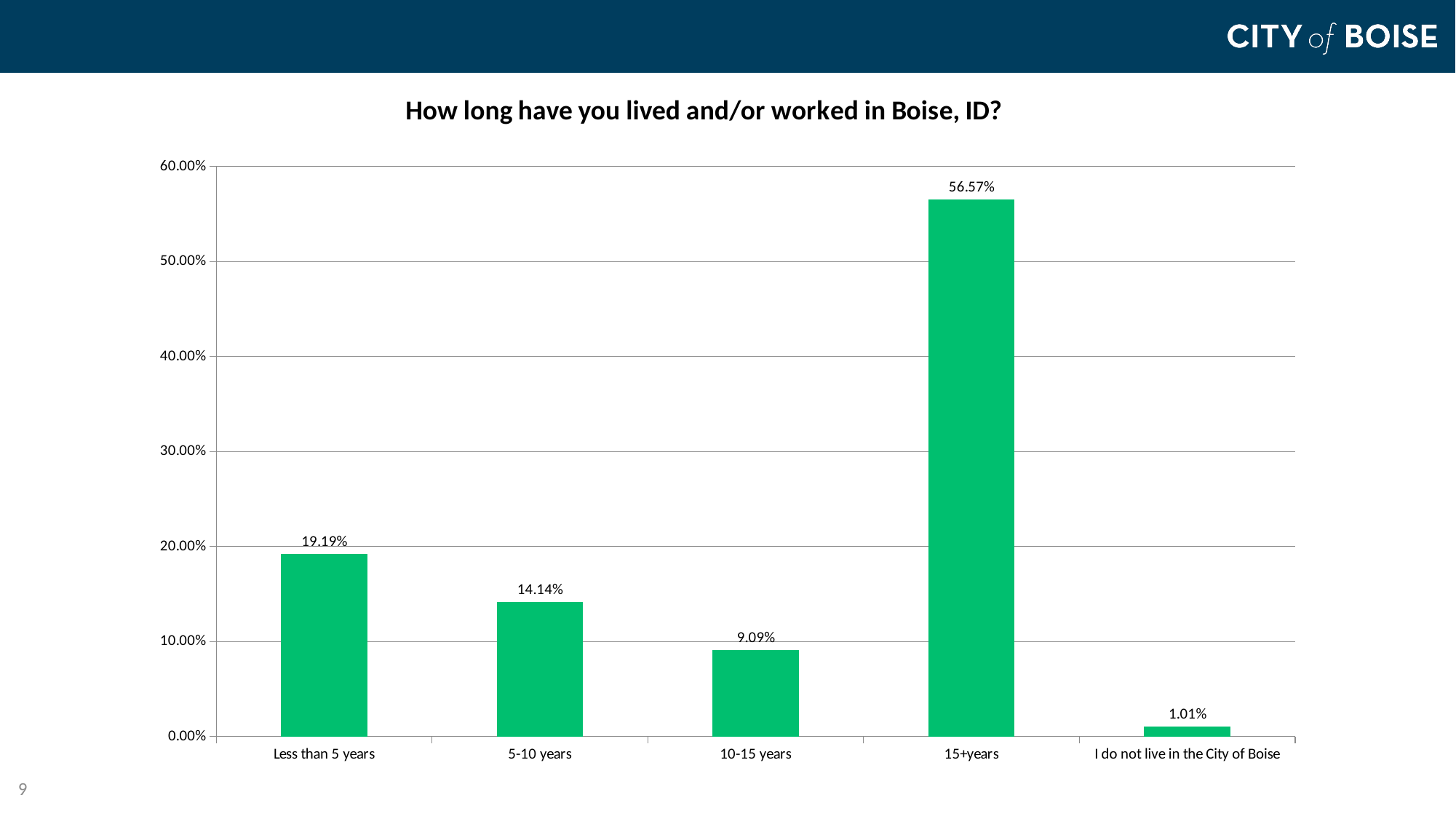
Which category has the highest value? 15+years What is the difference between the values for Less than 5 years and 5-10 years? 5.05% What is the value for Less than 5 years? 19.19% What kind of chart is shown on the slide? bar chart What is the value for I do not live in the City of Boise? 1.01% What is the value for 10-15 years? 9.09% Is the value for 15+years greater or less than 50.00%? greater Which is larger, the value for 5-10 years or the value for 10-15 years? 5-10 years What is the value for 15+years? 56.57% How many categories are shown on the x axis? 5 Which category has the lowest value? I do not live in the City of Boise What is the title of the chart? How long have you lived and/or worked in Boise, ID?